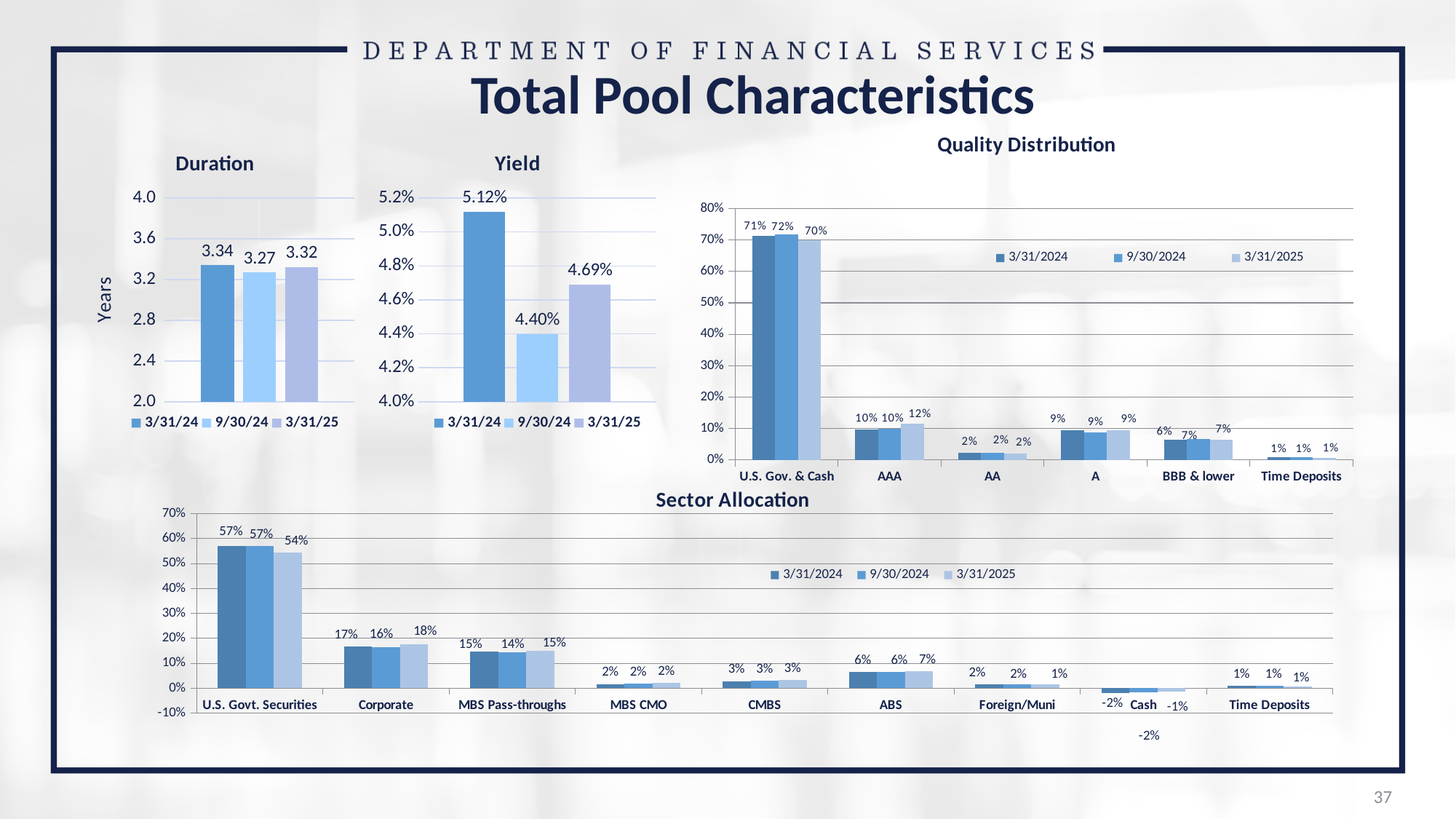
In the Yield chart, what is the yield for 3/31/25? 4.69% In the Sector Allocation chart, how many series does the legend list? 3 In the Duration chart, which date has the highest duration? 3/31/24 In the Sector Allocation chart, which is larger for 9/30/2024: MBS Pass-throughs or ABS? MBS Pass-throughs What kind of chart is the Duration chart? Bar chart In the Duration chart, what is the duration for 9/30/24? 3.27 In the Sector Allocation chart, what is the value for Corporate on 3/31/2025? 18% In the Quality Distribution chart, what is the value for BBB & lower on 3/31/2024? 6% In the Yield chart, what is the difference between the yield for 3/31/24 and the yield for 9/30/24? 0.72% In the Quality Distribution chart, what is the value for AAA on 3/31/2025? 12% In the Yield chart, which date has the lowest yield? 9/30/24 In the Quality Distribution chart, how many categories are shown on the x axis? 6